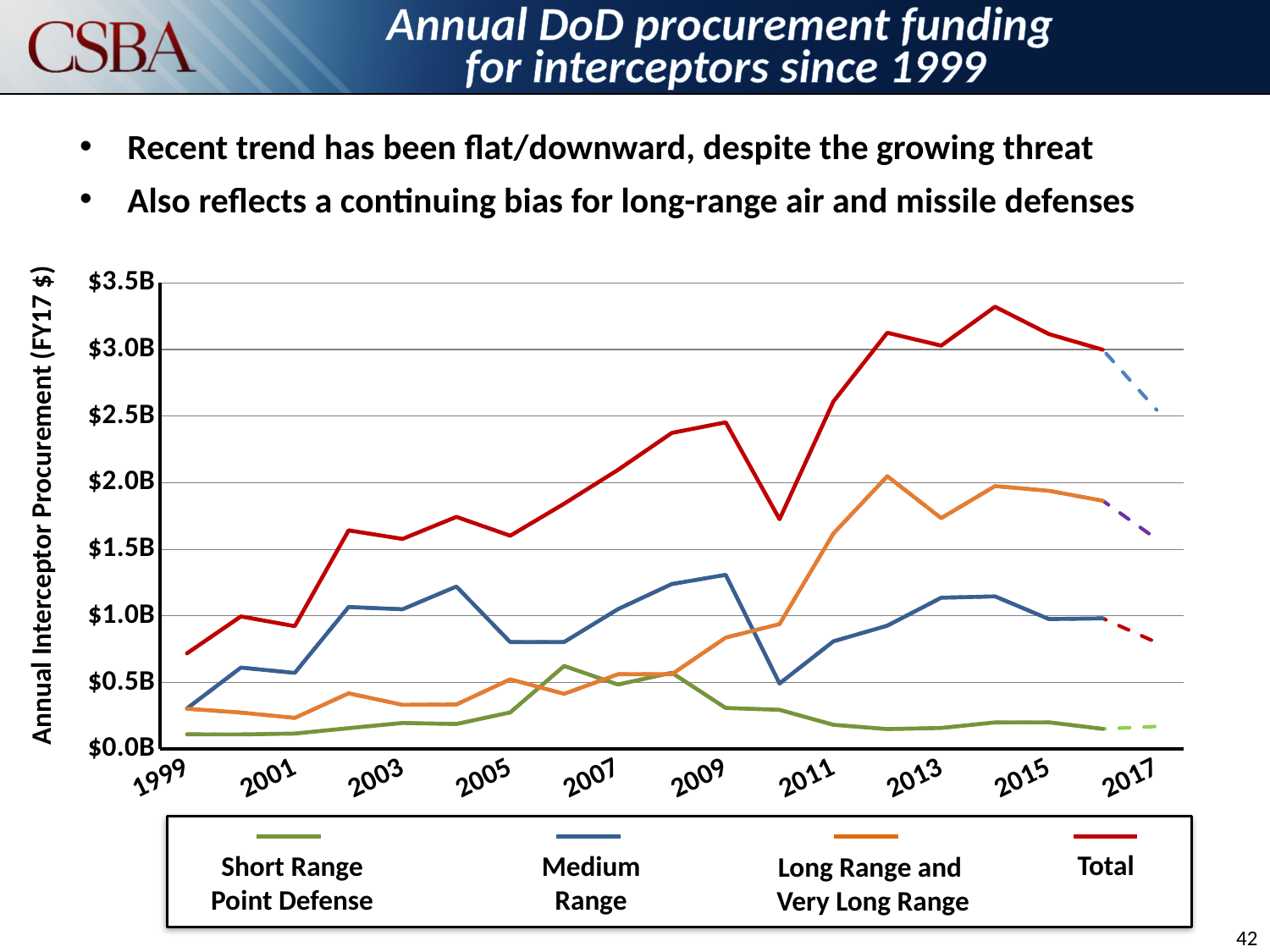
Does the Total series rise or fall from 1999 to 2009? rise How many series does the legend list? 4 Is the value for Total in 2014 greater or less than $3.0B? greater What is the label of the y axis? Annual Interceptor Procurement (FY17 $) Is the value for Long Range and Very Long Range in 2012 greater or less than $1.5B? greater Is the value for Total in 2010 greater or less than $2.0B? less In 2009, which is larger: Medium Range or Long Range and Very Long Range? Medium Range What kind of chart is shown on the slide? line chart In 2016, which is larger: Long Range and Very Long Range or Medium Range? Long Range and Very Long Range Which series is drawn in red? Total